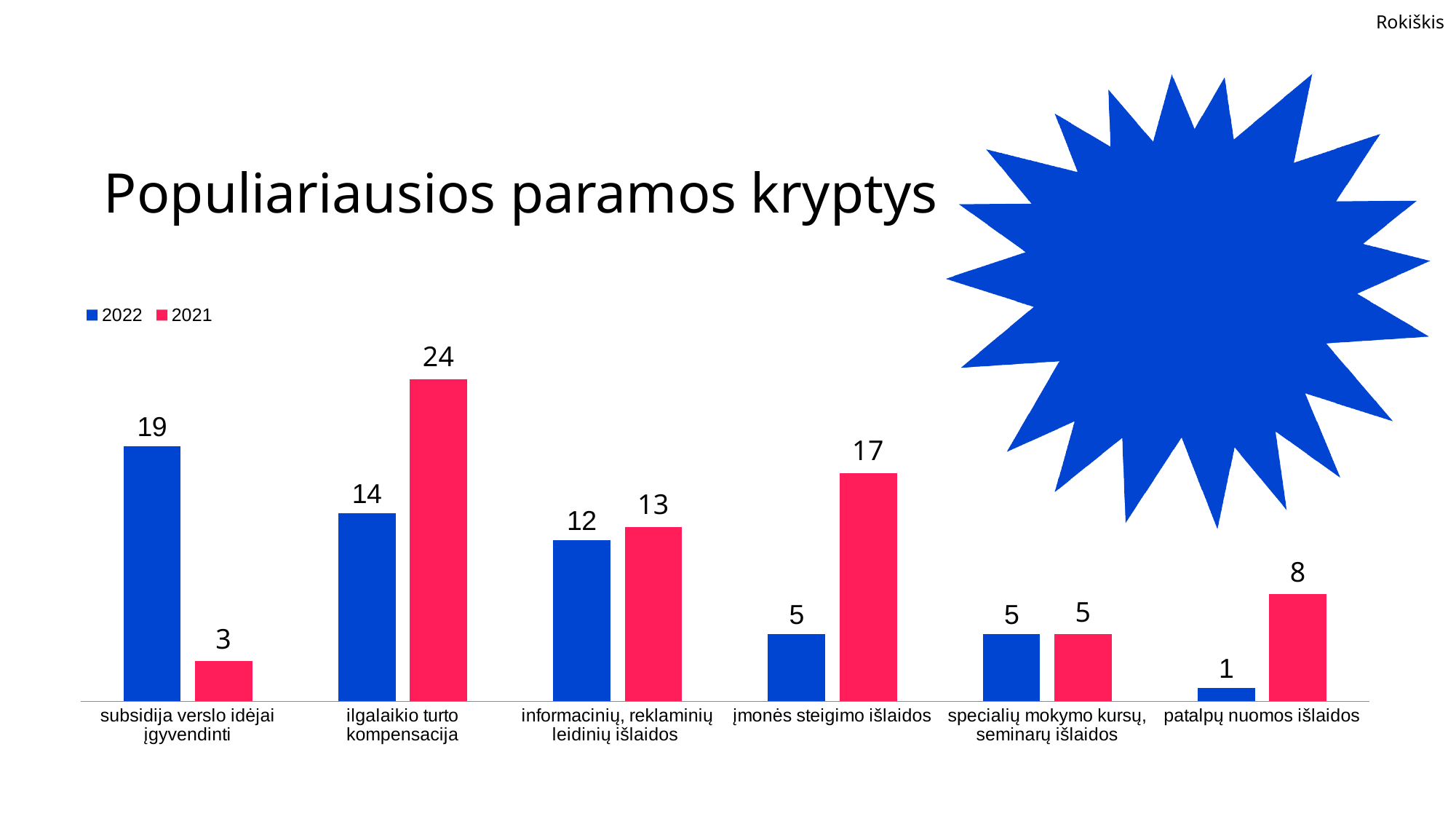
What is the 2022 value for 'subsidija verslo idėjai įgyvendinti'? 19 Which series is shown in blue? 2022 What is the 2021 value for 'ilgalaikio turto kompensacija'? 24 Which category has the highest 2021 value? ilgalaikio turto kompensacija How many categories are shown on the x axis? 6 Which is larger for 'informacinių, reklaminių leidinių išlaidos': the 2022 value or the 2021 value? 2021 How many series does the legend list? 2 What is the difference between the 2021 and 2022 values for 'įmonės steigimo išlaidos'? 12 Which category has the lowest 2022 value? patalpų nuomos išlaidos What kind of chart is shown on the slide? bar chart What is the 2021 value for 'patalpų nuomos išlaidos'? 8 What is the title of the slide? Populiariausios paramos kryptys